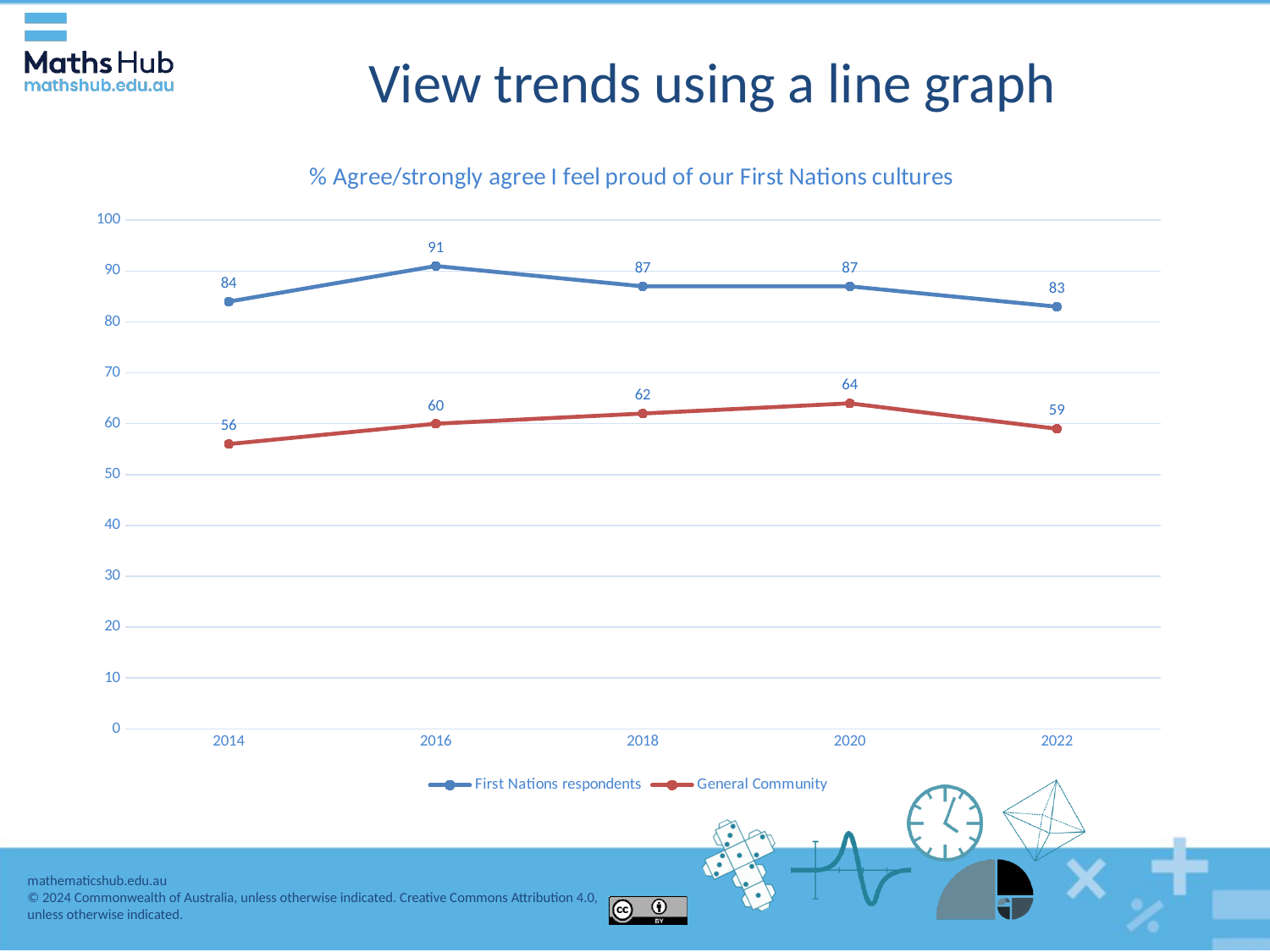
In which year is the General Community value highest? 2020 What kind of chart is shown on the slide? Line chart In which year is the First Nations respondents value lowest? 2022 What is the value for General Community in 2014? 56 What is the title of the chart? % Agree/strongly agree I feel proud of our First Nations cultures How many years are plotted on the x axis? 5 What is the value for First Nations respondents in 2022? 83 How many series does the legend list? 2 Which is larger in 2020: First Nations respondents or General Community? First Nations respondents Does the General Community value rise or fall from 2014 to 2020? Rise What is the value for First Nations respondents in 2016? 91 What is the difference between First Nations respondents and General Community in 2018? 25